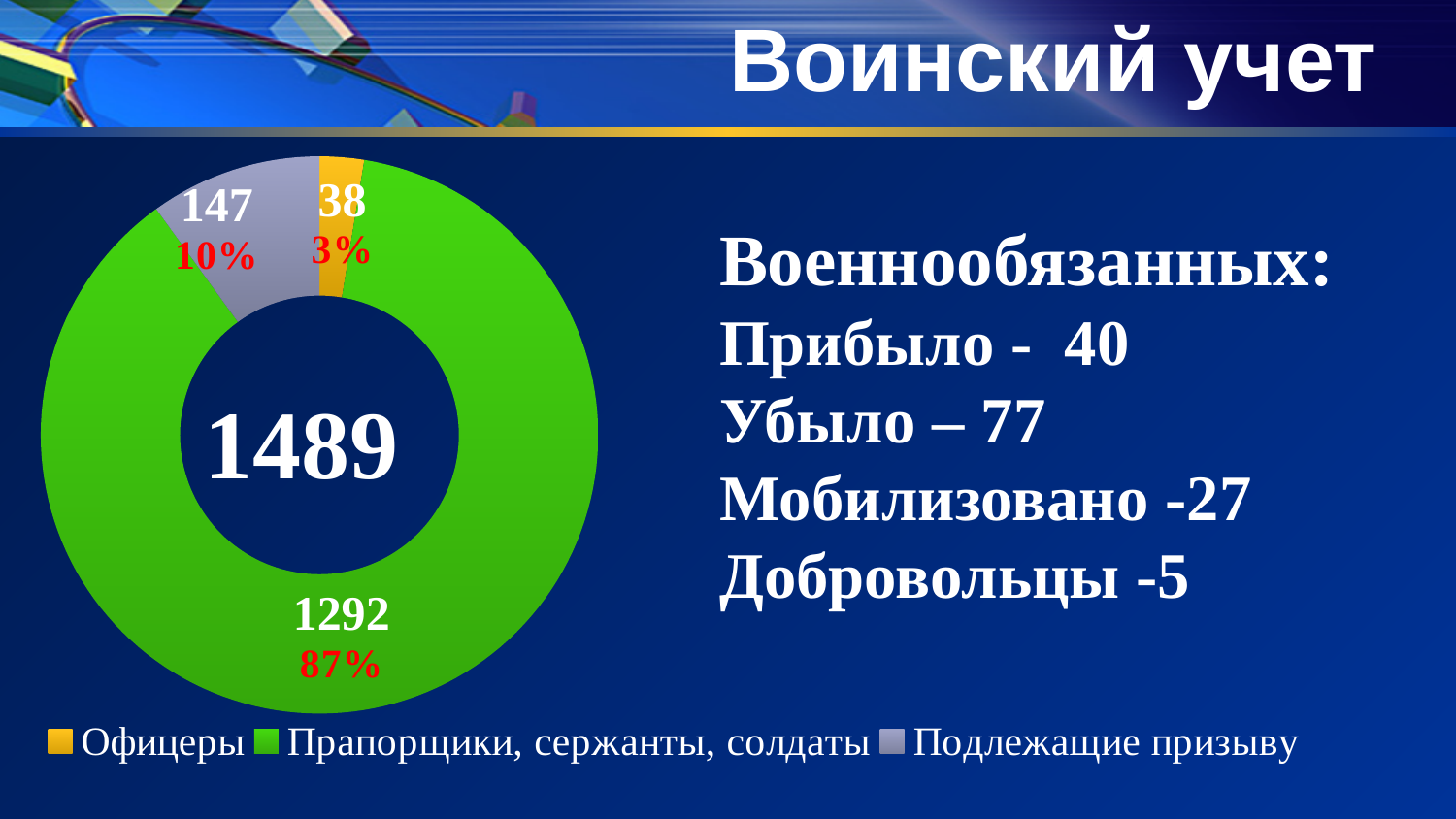
What is the value for Подлежащие призыву? 147 What kind of chart is shown on the slide? Doughnut chart Which category has the largest value? Прапорщики, сержанты, солдаты What share of the chart does Подлежащие призыву represent? 10% What total number is shown in the centre of the doughnut chart? 1489 What is the value for Прапорщики, сержанты, солдаты? 1292 What is the difference between the values for Подлежащие призыву and Офицеры? 109 Which is larger, the value for Подлежащие призыву or the value for Офицеры? Подлежащие призыву What is the value for Офицеры? 38 What share of the chart does Офицеры represent? 3% Which category has the smallest value? Офицеры How many categories does the chart show? 3